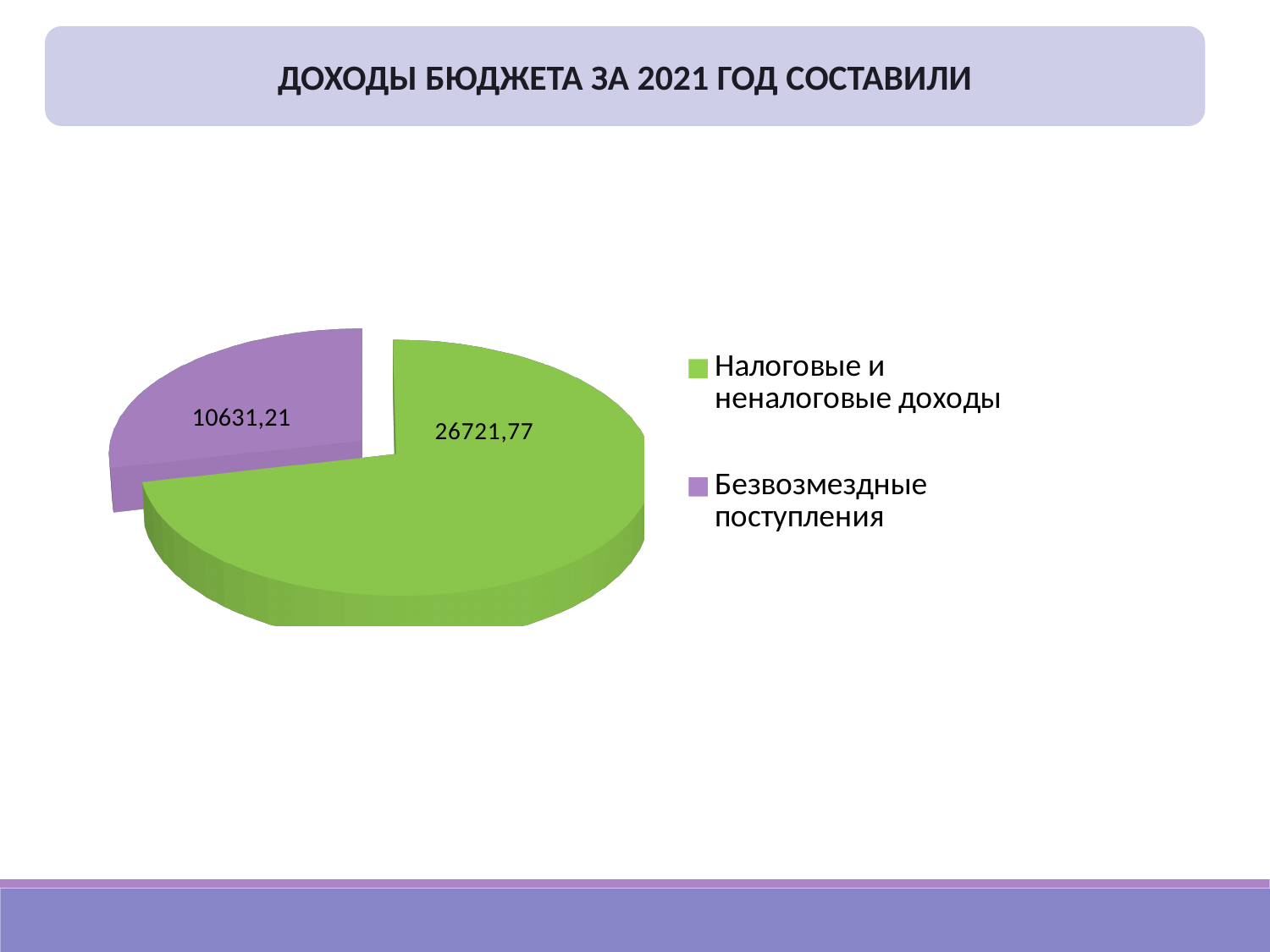
How many slices does the pie chart have? 2 How many entries does the legend list? 2 What is the difference between the values for Налоговые и неналоговые доходы and Безвозмездные поступления? 16090,56 What colour is the slice for Безвозмездные поступления? Purple What is the value for Налоговые и неналоговые доходы? 26721,77 What share of the pie does Налоговые и неналоговые доходы represent, to one decimal place? 71,5% Which is larger: Налоговые и неналоговые доходы or Безвозмездные поступления? Налоговые и неналоговые доходы What is the total of the two values shown in the pie chart? 37352,98 Which category has the smallest slice of the pie? Безвозмездные поступления Which category has the largest slice of the pie? Налоговые и неналоговые доходы What is the value for Безвозмездные поступления? 10631,21 What type of chart is shown on the slide? Pie chart